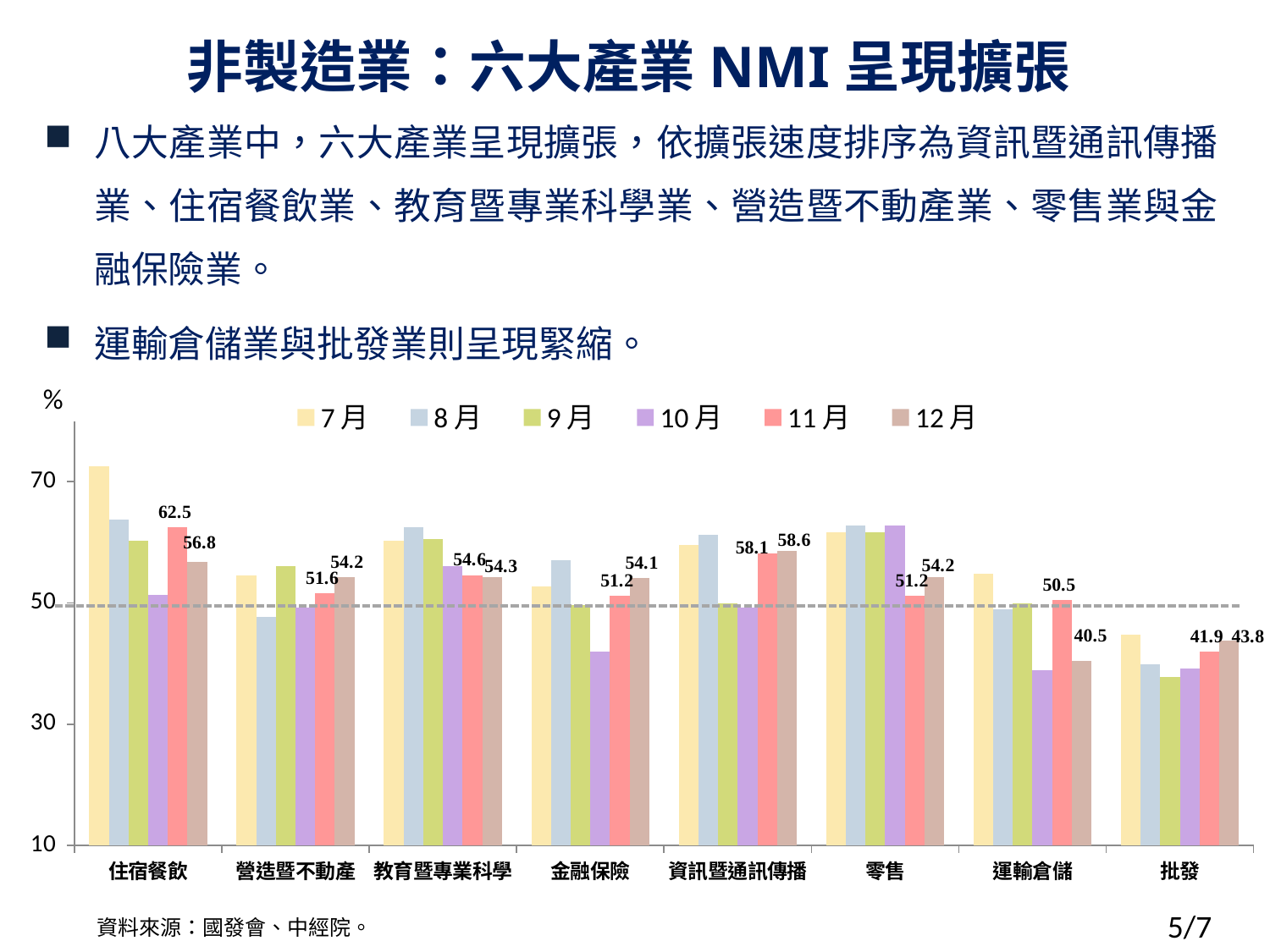
How many industries are shown on the x axis? 8 What is the 12月 value for 資訊暨通訊傳播? 58.6 How many series does the legend list? 6 Is the 7月 value for 住宿餐飲 greater or less than 70? greater Which industry has the lowest 12月 value? 運輸倉儲 Which is larger for 批發: the 11月 value or the 12月 value? 12月 What kind of chart is shown on the slide? bar chart What is the 11月 value for 住宿餐飲? 62.5 What is the difference between the 11月 and 12月 values for 住宿餐飲? 5.7 At what value is the horizontal dashed reference line drawn? 50 Which industry has the highest 12月 value? 資訊暨通訊傳播 What is the 12月 value for 運輸倉儲? 40.5